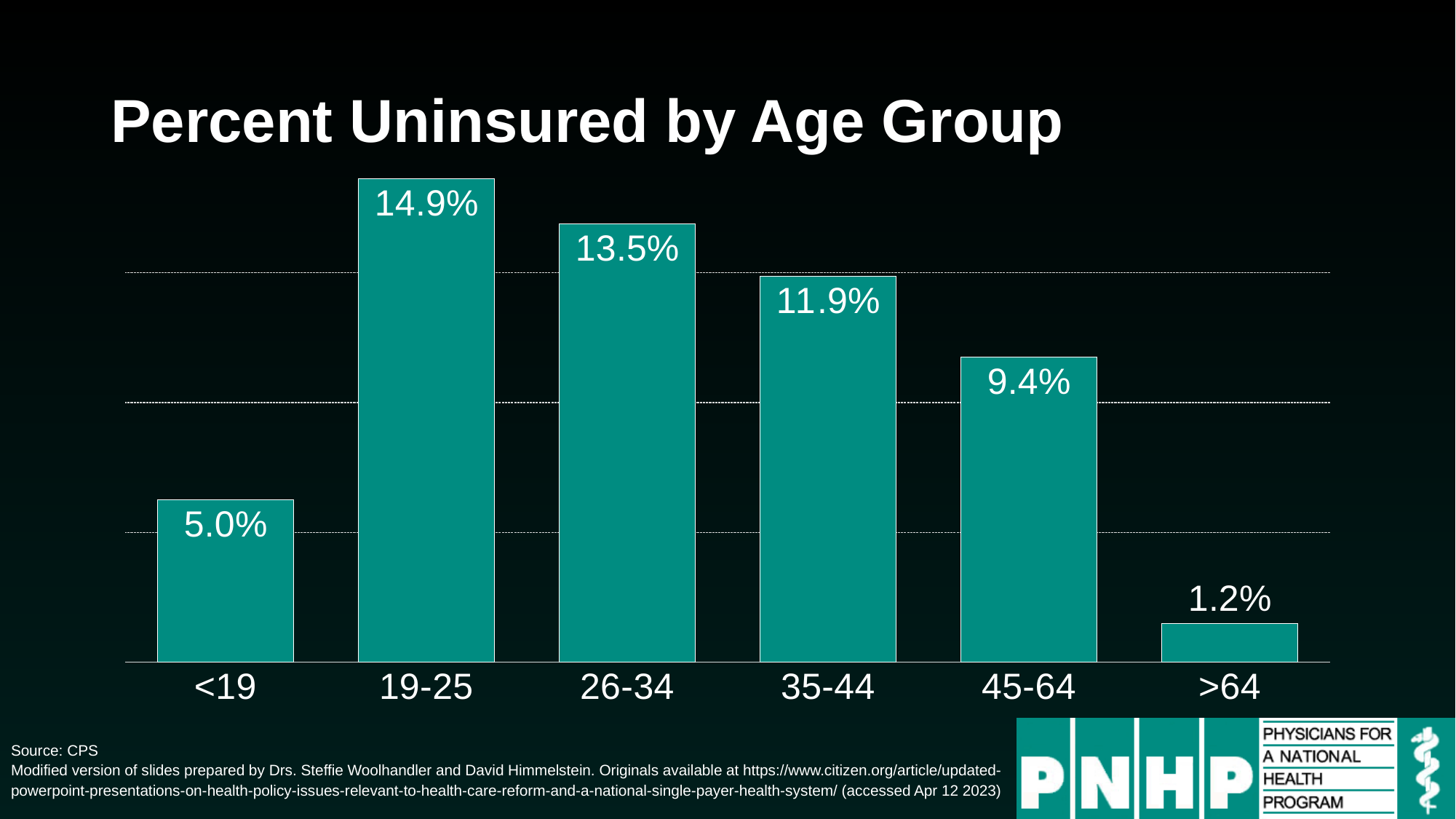
What is the percent uninsured for the 35-44 age group? 11.9% What kind of chart is shown on the slide? Bar chart What is the percent uninsured for the 19-25 age group? 14.9% What is the percent uninsured for the >64 age group? 1.2% Which age group has the highest percent uninsured? 19-25 What is the difference in percent uninsured between the 19-25 and 26-34 age groups? 1.4% Does the percent uninsured rise or fall from the 19-25 age group to the >64 age group? Fall How many age groups are shown in the chart? 6 What is the difference in percent uninsured between the <19 and 45-64 age groups? 4.4% Which age group has a higher percent uninsured, <19 or 45-64? 45-64 What is the title of the chart? Percent Uninsured by Age Group Which age group has the lowest percent uninsured? >64